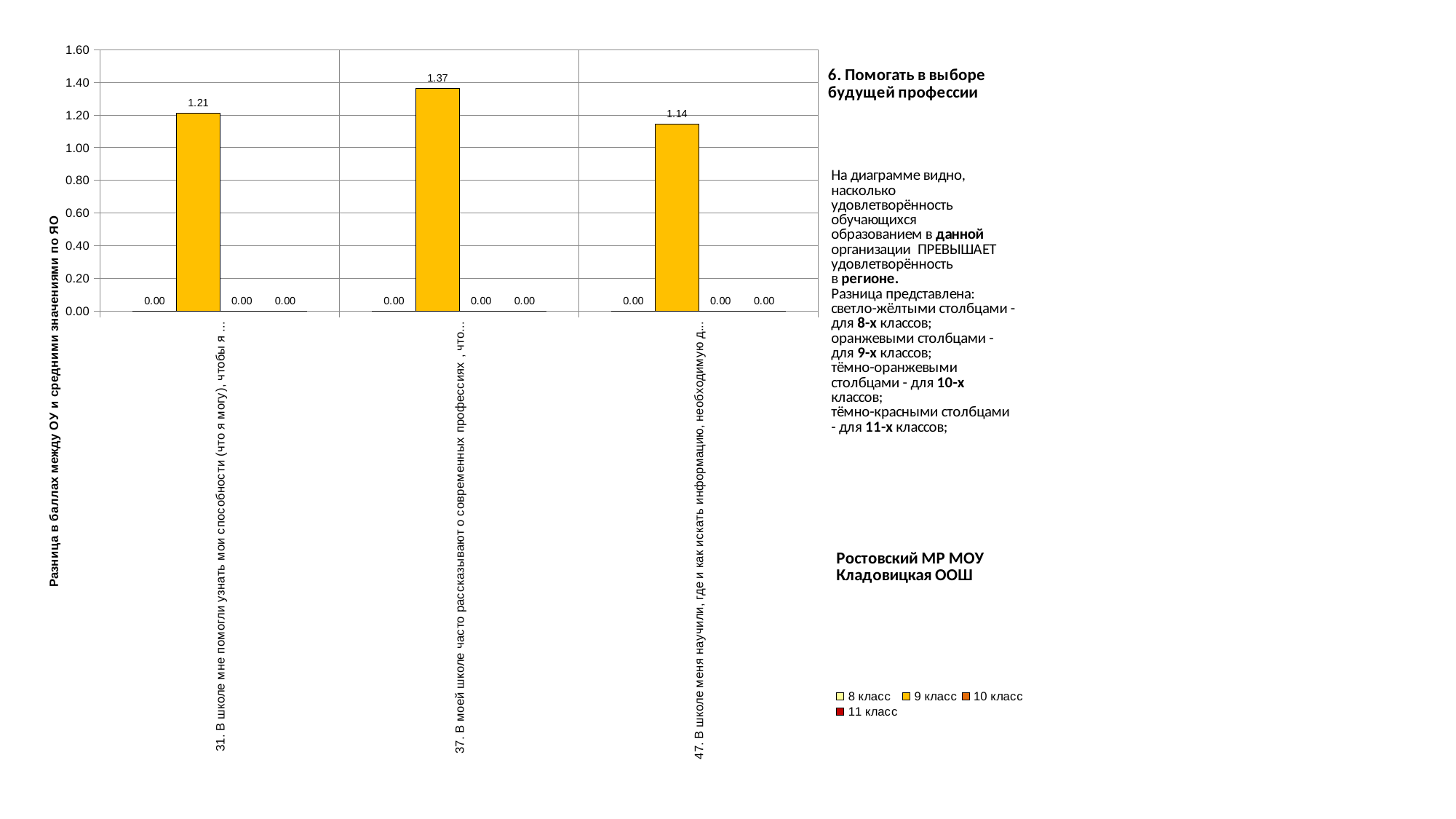
How many categories (questions) are shown on the x axis? 3 Which is larger: the 9 класс value for question 31 or for question 47? question 31 What is the difference between the 9 класс values for question 37 and question 31? 0.16 What is the value for 8 класс for question 37? 0.00 What is the value for 9 класс for question 47? 1.14 For which question is the 9 класс value highest? 37 Which series is the only one with non-zero values in the chart? 9 класс What type of chart is shown on the slide? bar chart What is the value for 9 класс for question 37? 1.37 How many series does the legend list? 4 What is the value for 9 класс for question 31? 1.21 For which question is the 9 класс value lowest? 47